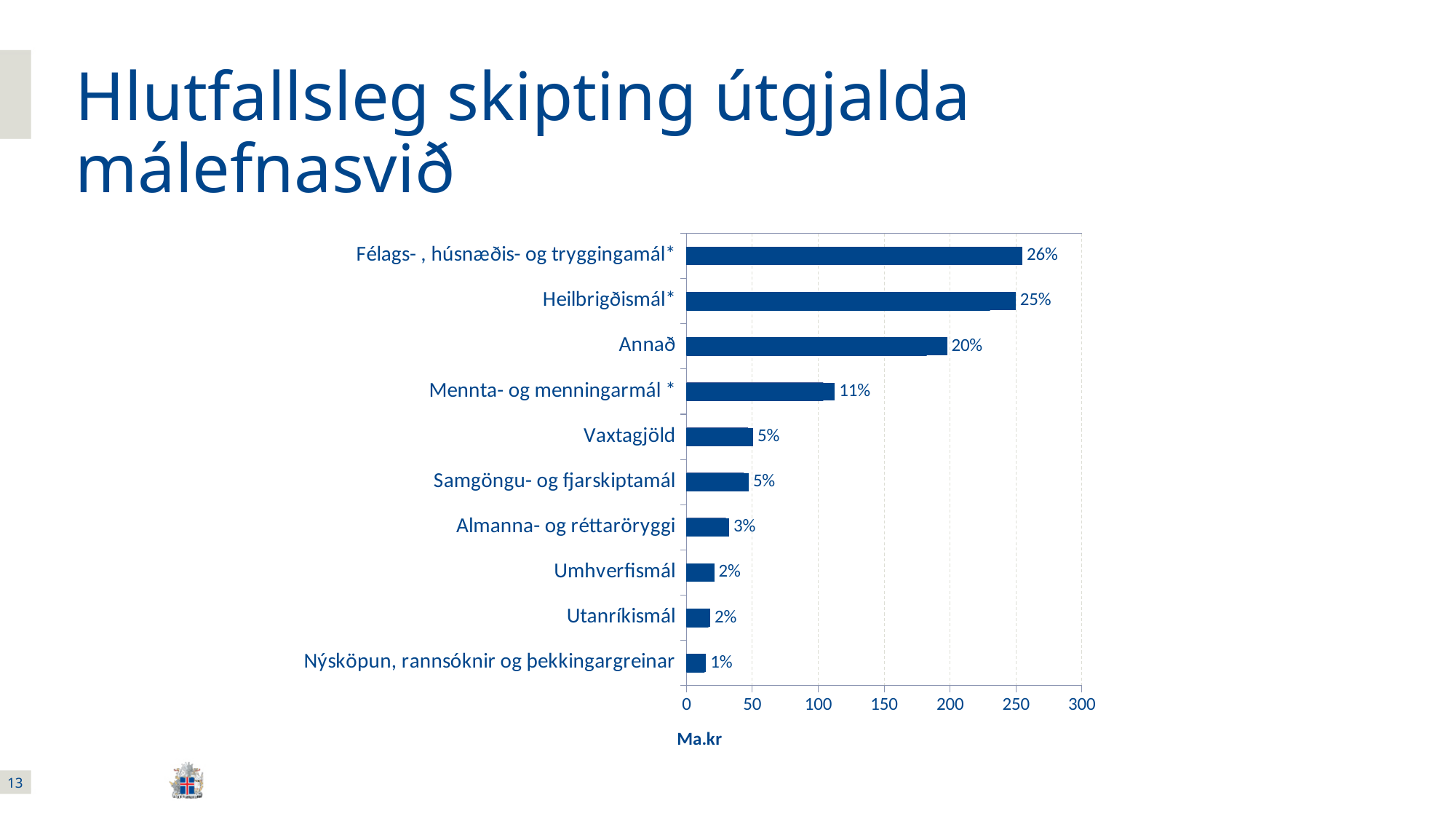
What is the difference in percentage points between the labels for Félags- , húsnæðis- og tryggingamál* and Mennta- og menningarmál *? 15% Is the value in Ma.kr for Almanna- og réttaröryggi greater or less than 50? less What percentage label is shown for Almanna- og réttaröryggi? 3% Which category has the highest value in the chart? Félags- , húsnæðis- og tryggingamál* Is the value in Ma.kr for Heilbrigðismál* greater or less than 200? greater What kind of chart is shown on the slide? bar chart What percentage label is shown for Heilbrigðismál*? 25% How many categories are shown in the chart? 10 Which has a larger value, Annað or Mennta- og menningarmál *? Annað What percentage label is shown for Mennta- og menningarmál *? 11% Which category has the lowest value in the chart? Nýsköpun, rannsóknir og þekkingargreinar What unit is shown on the horizontal axis of the chart? Ma.kr